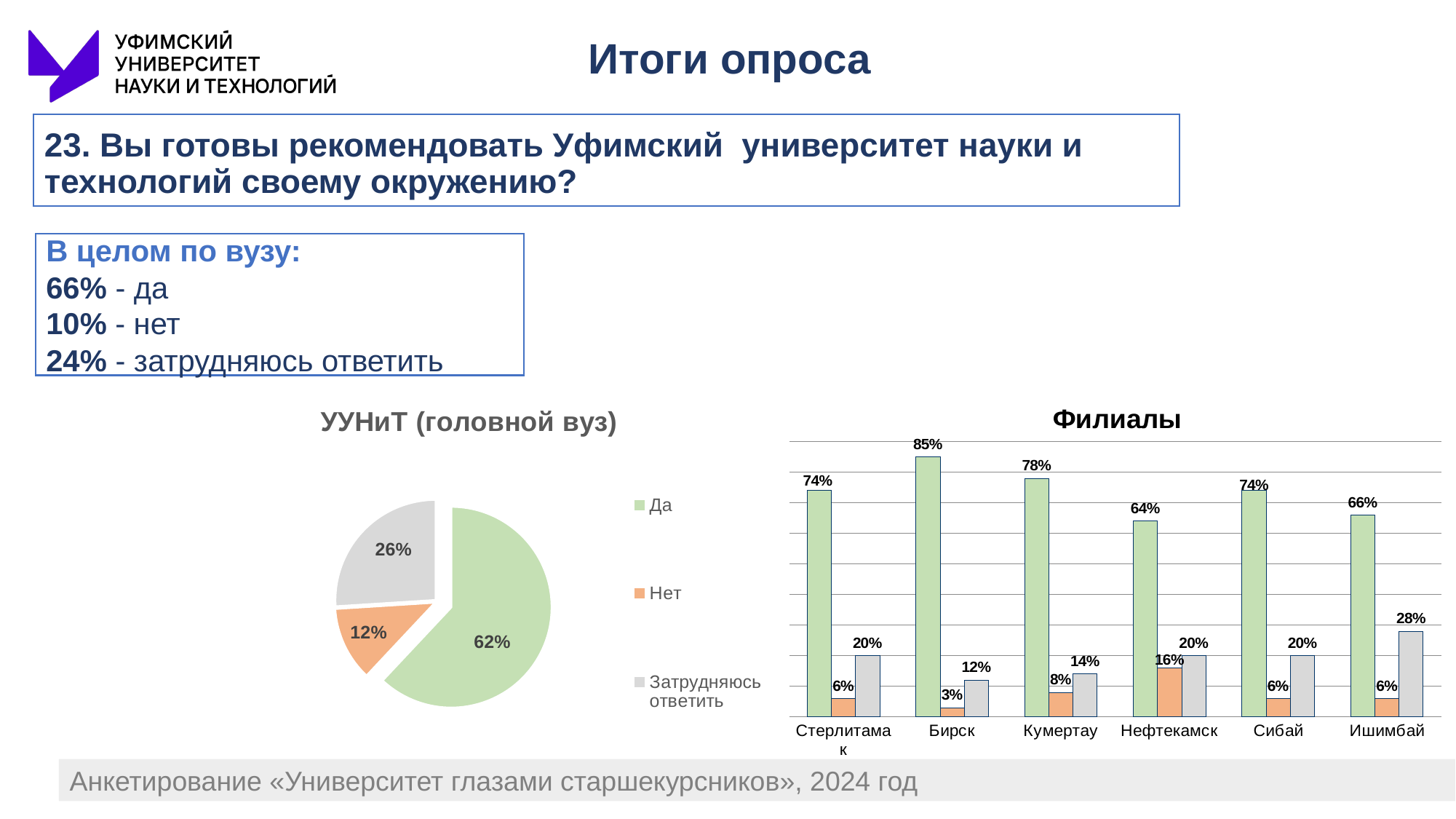
In the pie chart 'УУНиТ (головной вуз)', which slice is the smallest? Нет In the pie chart 'УУНиТ (головной вуз)', what is the value for 'Нет'? 12% What kind of chart is the 'УУНиТ (головной вуз)' chart? Pie chart In the 'Филиалы' chart, what is the value of the grey ('Затрудняюсь ответить') bar for Ишимбай? 28% In the 'Филиалы' chart, what is the value of the green ('Да') bar for Нефтекамск? 64% In the 'Филиалы' chart, which branch has the highest green ('Да') bar? Бирск In the pie chart 'УУНиТ (головной вуз)', how many entries does the legend list? 3 What kind of chart is the 'Филиалы' chart? Bar chart In the pie chart 'УУНиТ (головной вуз)', what share of the pie is the 'Да' slice? 62% In the 'Филиалы' chart, what is the difference between the green ('Да') bars for Бирск and Кумертау? 7% In the 'Филиалы' chart, how many branches (categories) are shown on the x axis? 6 In the 'Филиалы' chart, which branch has the highest orange ('Нет') bar? Нефтекамск